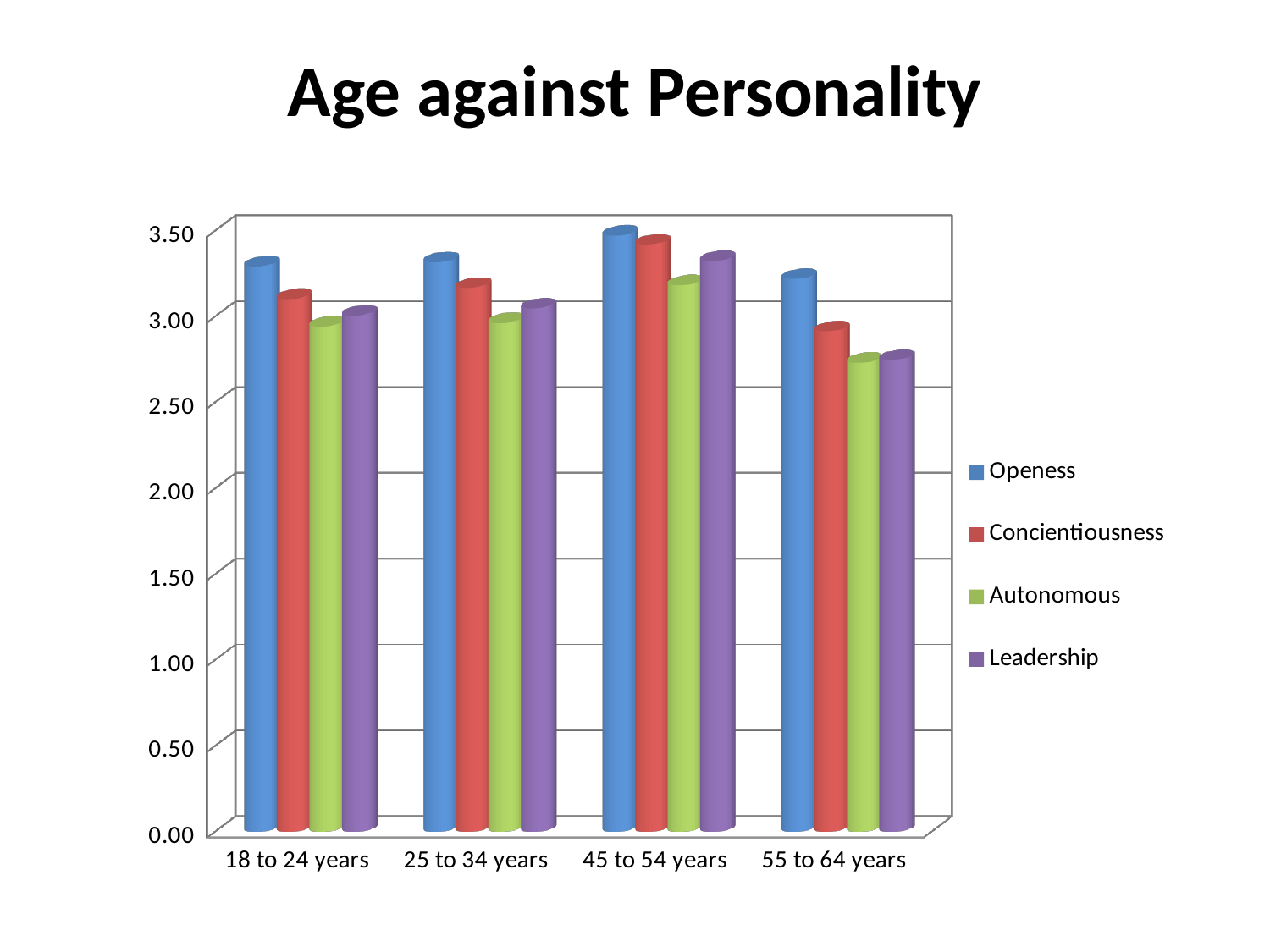
Is the Autonomous value for 55 to 64 years greater or less than 3.00? less Is the Leadership value for 55 to 64 years greater or less than 3.00? less Which age group has the highest Openess value? 45 to 54 years In the 55 to 64 years group, which series has the highest value? Openess Which age group has the lowest Autonomous value? 55 to 64 years How many age groups are shown on the x axis? 4 What is the title of the chart? Age against Personality Is the Openess value for 45 to 54 years greater or less than 3.00? greater Which series is shown in green in the legend? Autonomous What kind of chart is shown on the slide? bar chart In the 45 to 54 years group, which is larger: Openess or Autonomous? Openess How many series does the legend list? 4